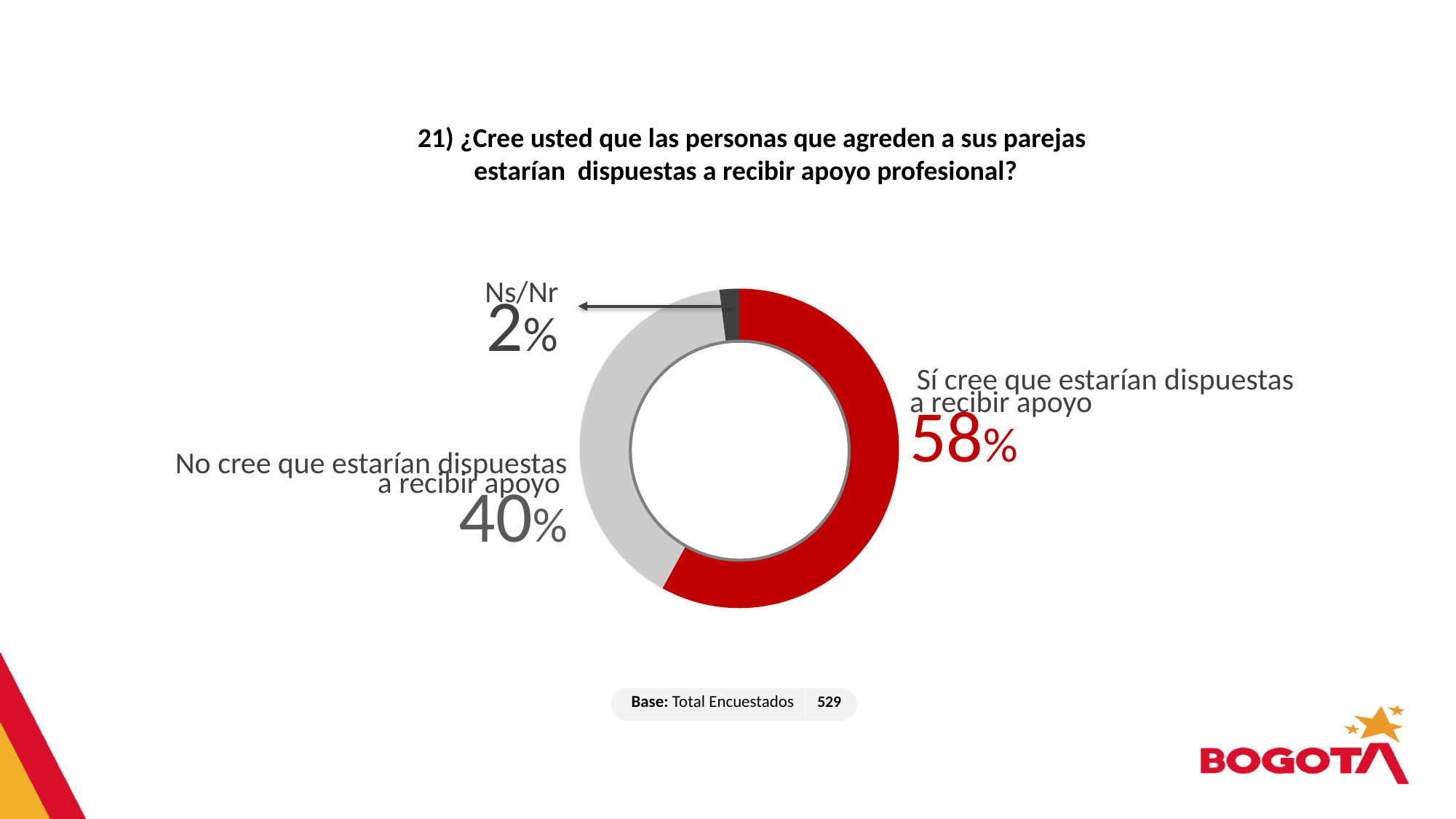
What kind of chart is shown on the slide? Doughnut (pie) chart What percentage of respondents believe that people who assault their partners would be willing to receive professional support (Sí cree que estarían dispuestas a recibir apoyo)? 58% What percentage of respondents do not believe they would be willing to receive support (No cree que estarían dispuestas a recibir apoyo)? 40% What percentage is shown for Ns/Nr? 2% What colour is the segment for 'Sí cree que estarían dispuestas a recibir apoyo'? Red How many categories are shown in the chart? 3 What is the base (number of respondents) shown below the chart? 529 Which category has the largest share of the chart? Sí cree que estarían dispuestas a recibir apoyo Which category has the smallest share of the chart? Ns/Nr Which is larger: the share for 'Sí cree que estarían dispuestas a recibir apoyo' or 'No cree que estarían dispuestas a recibir apoyo'? Sí cree que estarían dispuestas a recibir apoyo What is the difference in percentage points between 'Sí cree' and 'No cree'? 18 What is the combined percentage of 'No cree' and 'Ns/Nr'? 42%